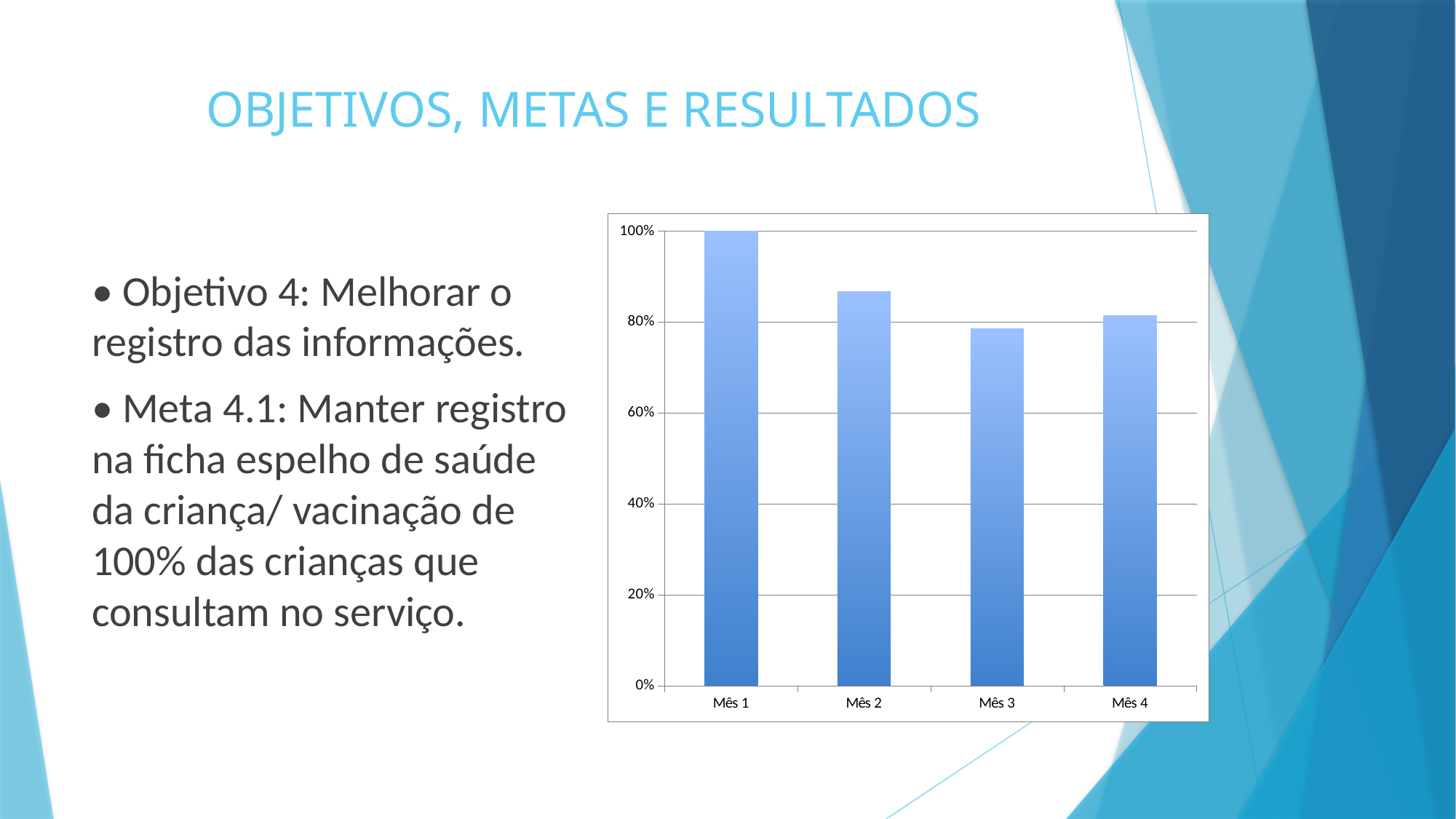
Which month has the lowest value? Mês 3 Do the values rise or fall from Mês 1 to Mês 3? fall Is the value for Mês 2 greater or less than 80%? greater How many months are shown on the x axis? 4 What is the highest value shown on the y axis? 100% Which month has the highest value? Mês 1 What kind of chart is shown on the slide? bar chart What is the value for Mês 1? 100% Which is larger, the value for Mês 1 or the value for Mês 4? Mês 1 Is the value for Mês 4 greater or less than 100%? less Is the value for Mês 3 greater or less than 60%? greater Which is larger, the value for Mês 2 or the value for Mês 3? Mês 2